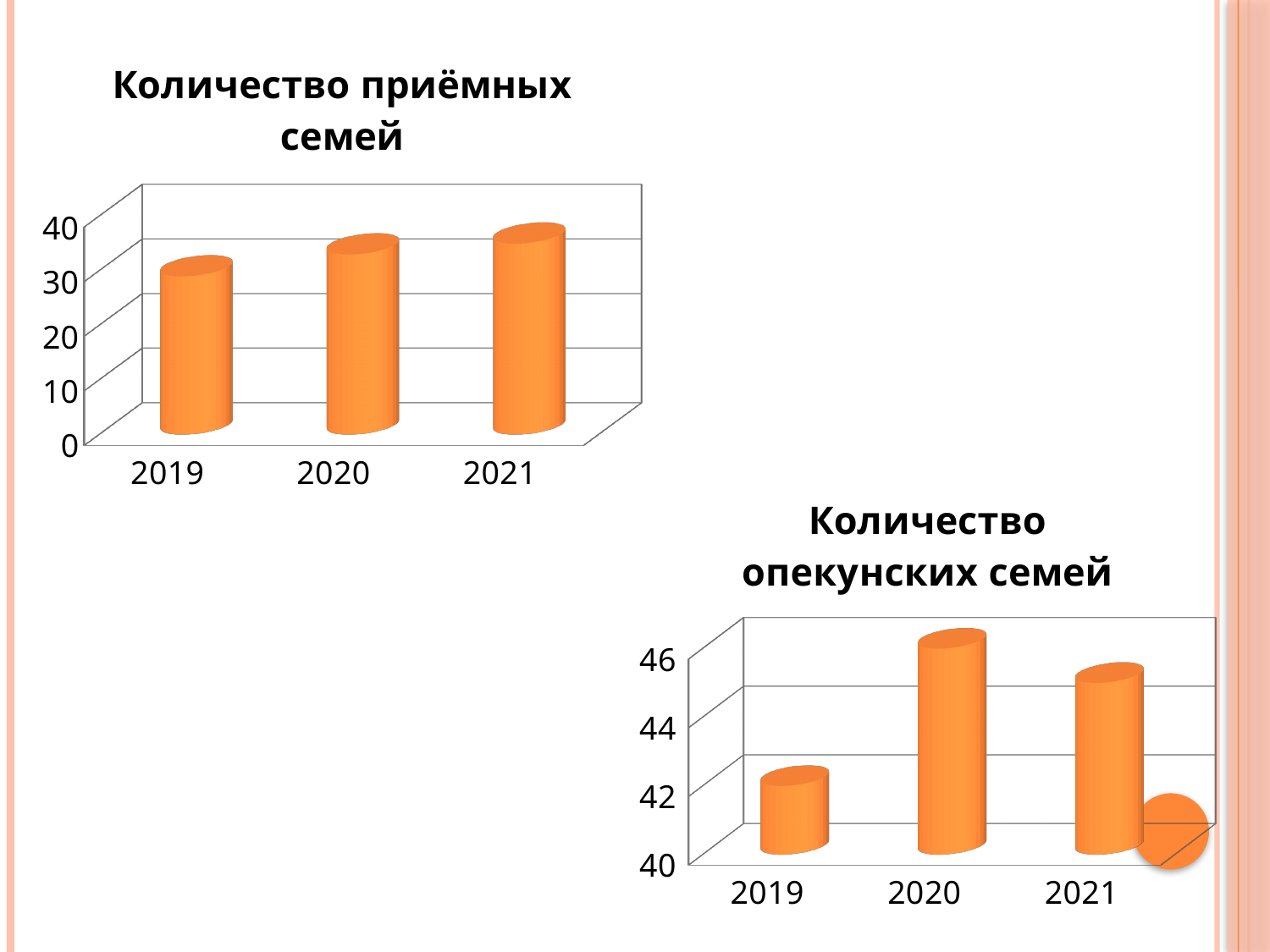
In the chart titled "Количество приёмных семей", which year has the highest value? 2021 In the chart titled "Количество приёмных семей", is the value for 2019 greater or less than 20? greater In the chart titled "Количество приёмных семей", which year has the lowest value? 2019 In the chart titled "Количество приёмных семей", is the value for 2021 greater or less than 40? less What kind of chart is the chart titled "Количество приёмных семей"? bar chart In the chart titled "Количество опекунских семей", is the value for 2019 greater or less than 44? less In the chart titled "Количество опекунских семей", which year has the highest value? 2020 In the chart titled "Количество опекунских семей", which is larger, the value for 2019 or the value for 2021? 2021 In the chart titled "Количество опекунских семей", which year has the lowest value? 2019 How many categories are shown on the x axis of the chart titled "Количество опекунских семей"? 3 In the chart titled "Количество приёмных семей", do the values rise or fall from 2019 to 2021? rise